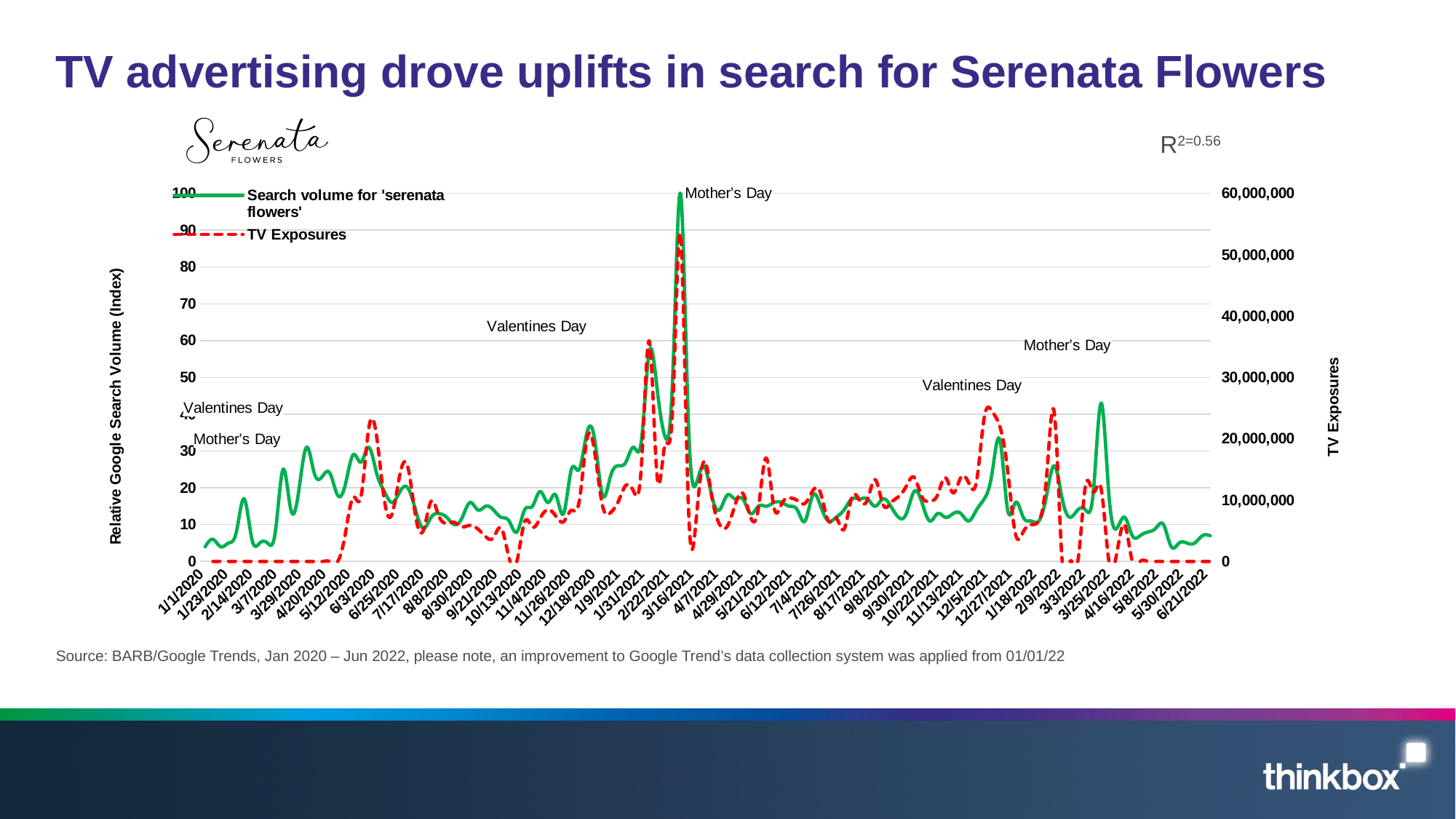
Which series is drawn as a red dashed line? TV Exposures What is the highest value shown on the right-hand TV Exposures axis? 60,000,000 Is the peak search volume for 'serenata flowers' near 3/16/2021 greater or less than 90? greater Is the peak of TV Exposures near 3/16/2021 greater or less than 50,000,000? greater What is the title of the left vertical axis? Relative Google Search Volume (Index) Is the value of TV Exposures on 1/1/2020 greater or less than 10,000,000? less Around which date does the search volume for 'serenata flowers' reach its highest point? 3/16/2021 How many series does the chart's legend list? 2 What kind of chart is shown on the slide? Line chart Which is larger: the search volume peak near 3/16/2021 or the search volume peak near 12/27/2021? The peak near 3/16/2021